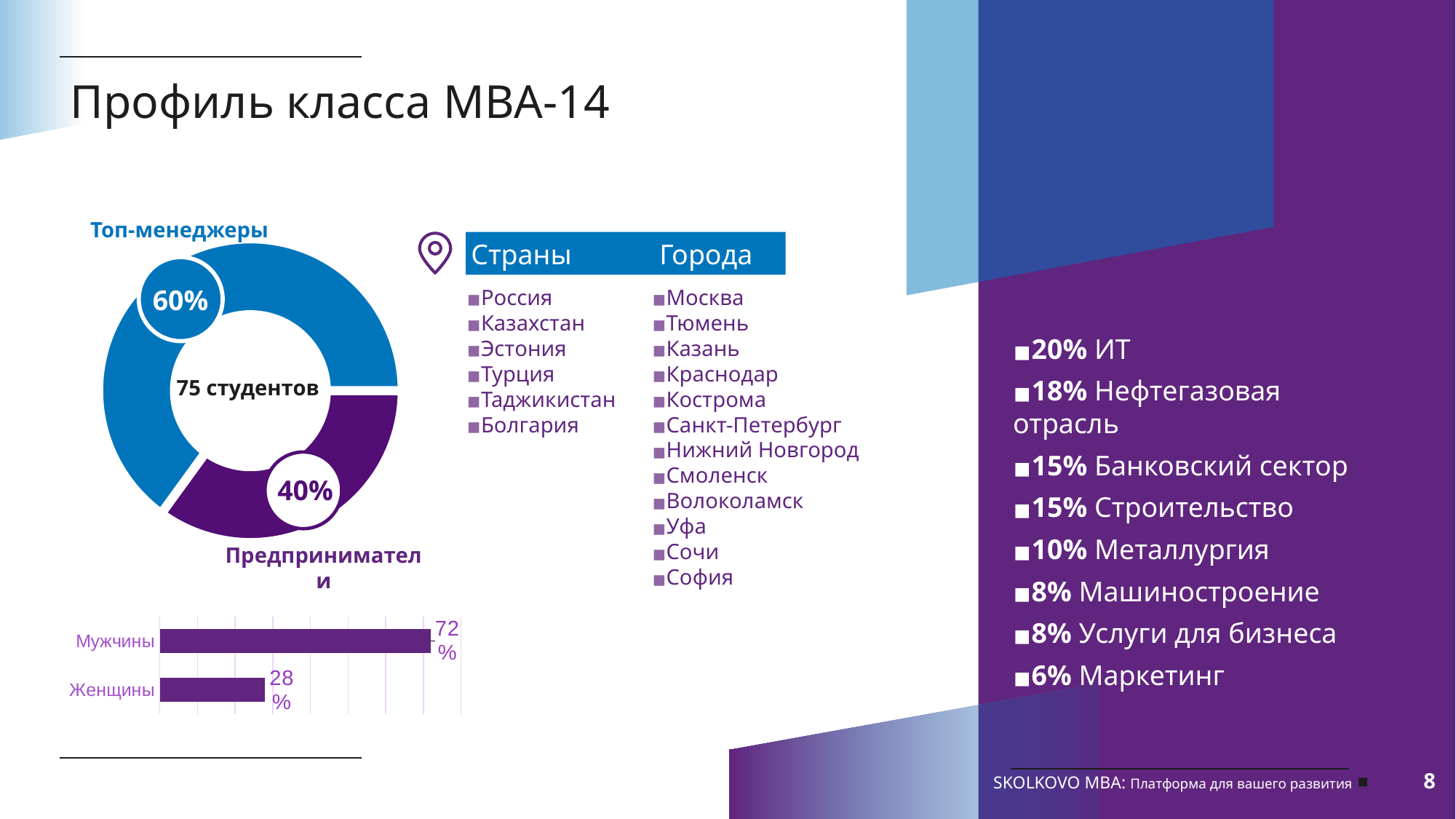
On the bar chart, which category has the highest value? Мужчины How many segments does the donut chart have? 2 What text is shown in the centre of the donut chart? 75 студентов On the bar chart, what is the value for Женщины? 28% On the donut chart, what is the difference in percentage points between Топ-менеджеры and Предприниматели? 20% How many categories are shown on the bar chart? 2 On the bar chart, what is the difference between the values for Мужчины and Женщины? 44% On the bar chart, what is the value for Мужчины? 72% On the donut chart, what share of the class are Топ-менеджеры? 60% What kind of chart is the one at the bottom left showing Мужчины and Женщины? bar chart On the donut chart, what share of the class are Предприниматели? 40% On the donut chart, which segment is larger, Топ-менеджеры or Предприниматели? Топ-менеджеры